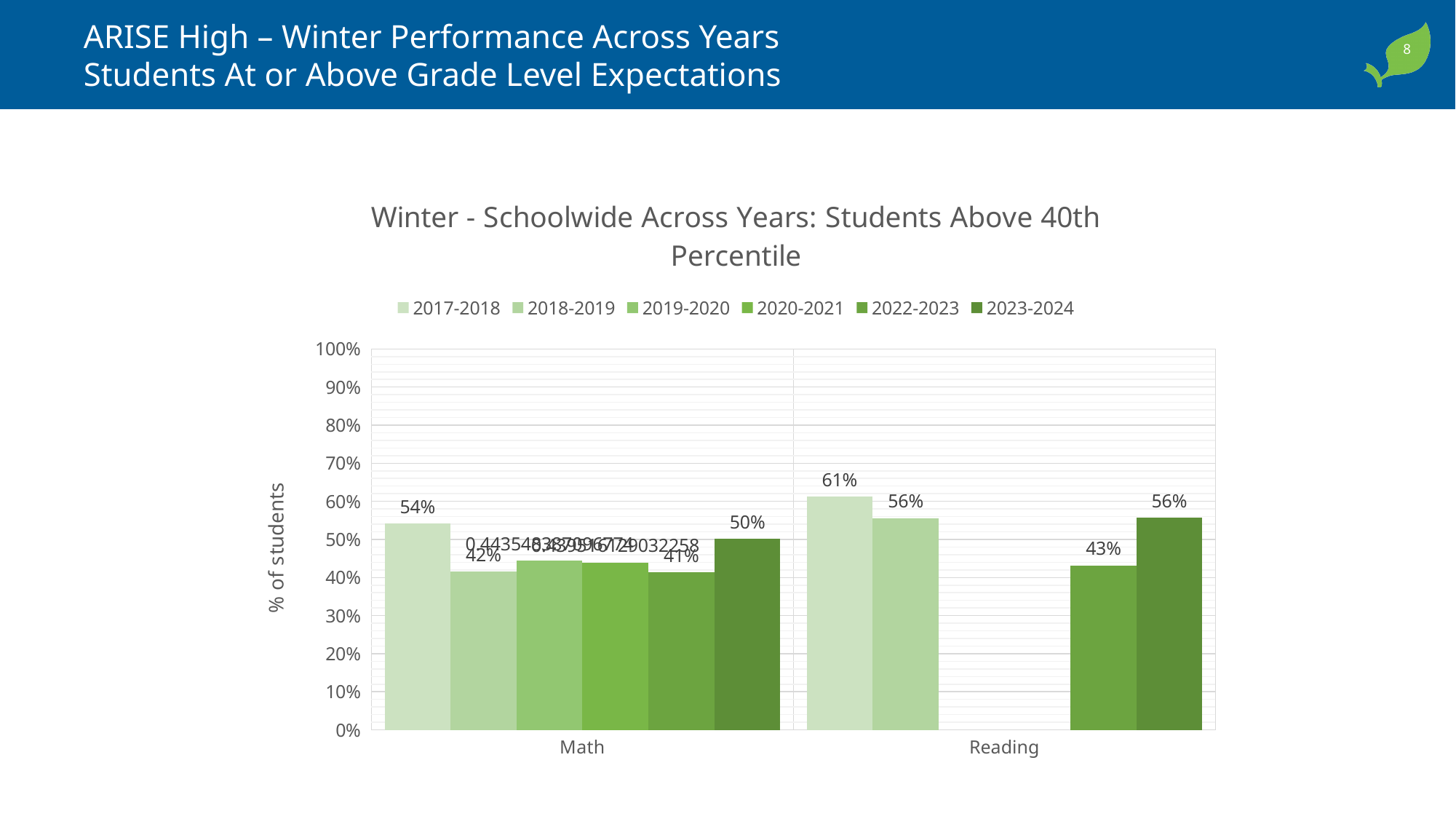
What is the value for 2017-2018 in the Math category? 54% What kind of chart is shown on the slide? Bar chart Which is larger: the 2017-2018 value for Math or the 2017-2018 value for Reading? Reading What is the value for 2018-2019 in the Math category? 42% What is the value for 2023-2024 in the Reading category? 56% What is the label on the vertical axis of the chart? % of students What is the value for 2022-2023 in the Reading category? 43% Is the value for 2019-2020 in the Math category greater or less than 50%? less Which school year has the lowest value in the Math category? 2022-2023 What is the difference between the 2017-2018 and 2022-2023 values in the Reading category? 18 percentage points How many series does the legend list? 6 Which school year has the highest value in the Reading category? 2017-2018